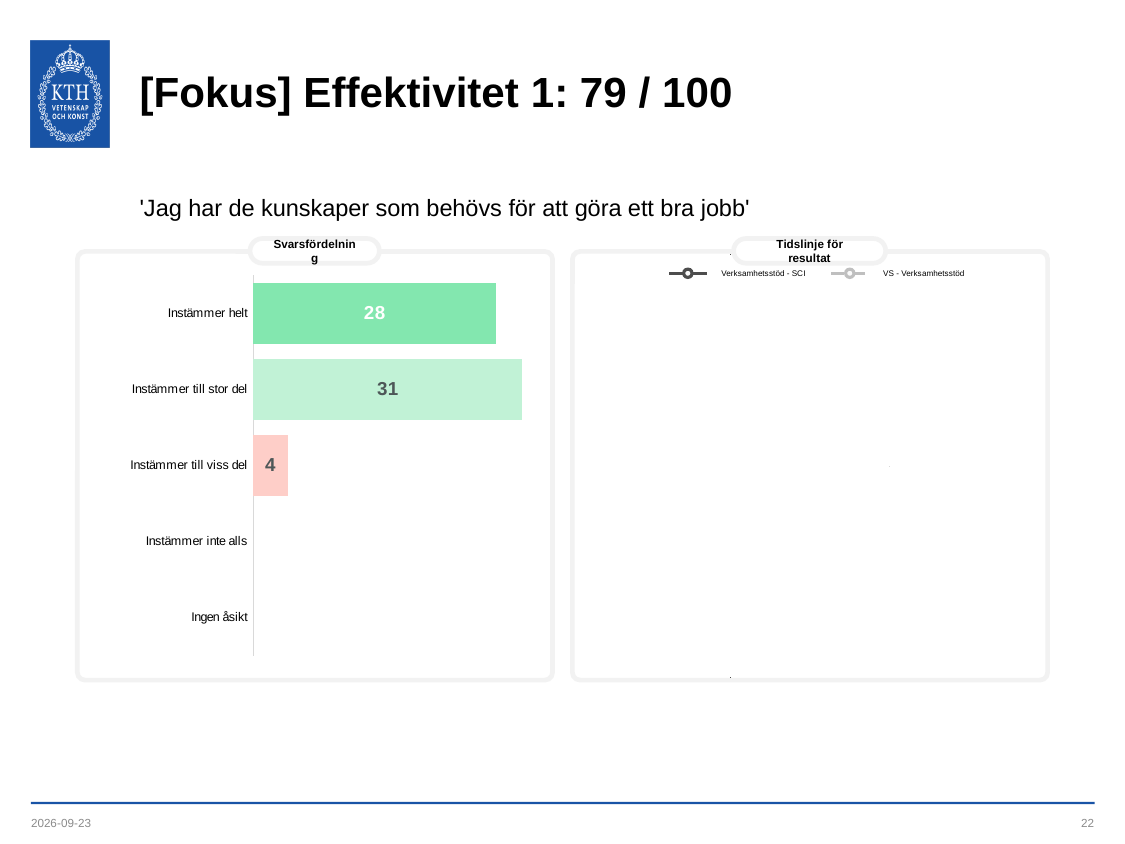
In the Svarsfördelning chart, which category has the highest value? Instämmer till stor del In the Svarsfördelning chart, what is the value for 'Instämmer till stor del'? 31 What statement is the Svarsfördelning chart about, as shown above the charts? 'Jag har de kunskaper som behövs för att göra ett bra jobb' In the Svarsfördelning chart, what is the difference between 'Instämmer till stor del' and 'Instämmer helt'? 3 In the Svarsfördelning chart, what is the value for 'Instämmer helt'? 28 How many categories are listed on the axis of the Svarsfördelning chart? 5 In the Svarsfördelning chart, what is the difference between 'Instämmer helt' and 'Instämmer till viss del'? 24 In the Svarsfördelning chart, what is the value for 'Instämmer till viss del'? 4 How many series does the legend of the 'Tidslinje för resultat' chart list? 2 What kind of chart is the Svarsfördelning chart? Bar chart In the Svarsfördelning chart, which is larger: 'Instämmer helt' or 'Instämmer till stor del'? Instämmer till stor del In the Svarsfördelning chart, which of the three labelled bars has the lowest value? Instämmer till viss del